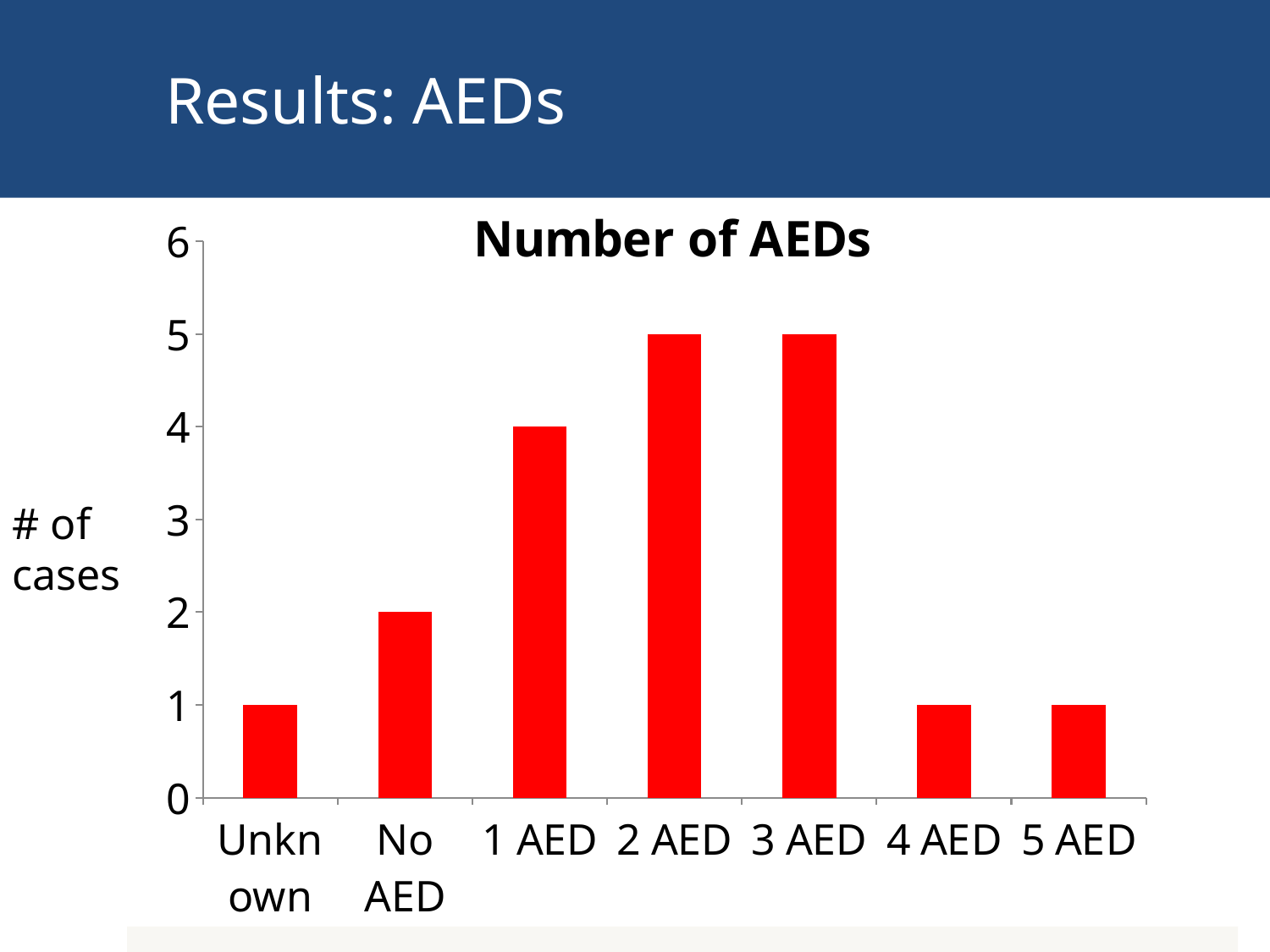
What is the number of cases for 1 AED? 4 What is the number of cases for Unknown? 1 What is the title of the chart? Number of AEDs Is the value for 1 AED greater or less than 3? greater What is the difference in number of cases between 2 AED and No AED? 3 What is the number of cases for 3 AED? 5 What is the number of cases for No AED? 2 What is the label on the y axis of the chart? # of cases How many categories are shown on the x axis of the chart? 7 What type of chart is shown on the slide? bar chart What is the number of cases for 2 AED? 5 Which has more cases, 1 AED or No AED? 1 AED